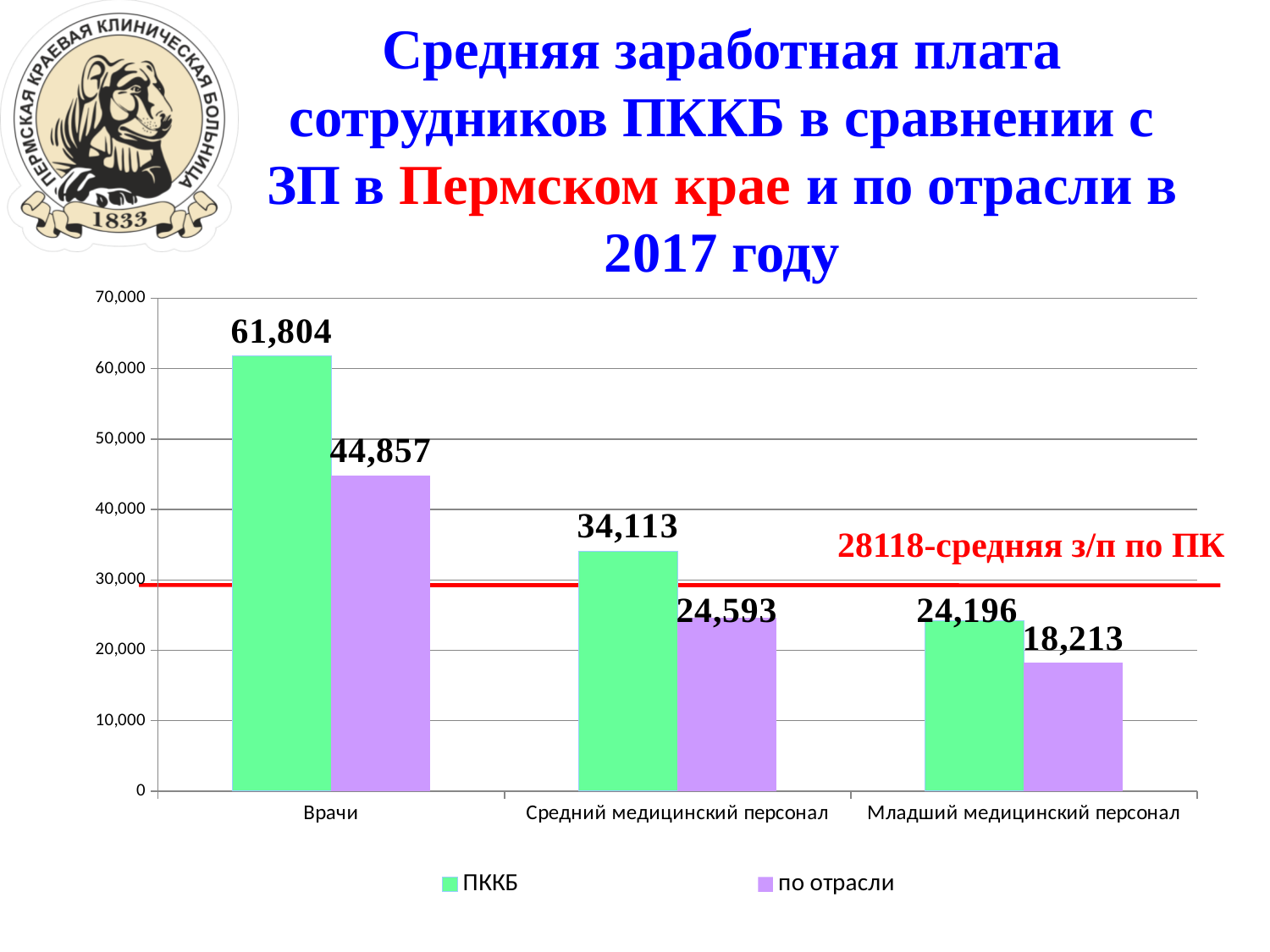
Which is larger for Средний медицинский персонал: the ПККБ value or the по отрасли value? ПККБ What is the по отрасли value for Средний медицинский персонал? 24,593 What is the ПККБ value for Младший медицинский персонал? 24,196 What kind of chart is shown on the slide? bar chart What is the difference between the ПККБ and по отрасли values for Врачи? 16,947 Which category has the highest ПККБ value? Врачи What is the difference between the ПККБ and по отрасли values for Младший медицинский персонал? 5,983 How many series does the legend list? 2 What is the ПККБ value for Врачи? 61,804 How many categories are shown on the x axis? 3 Which category has the lowest по отрасли value? Младший медицинский персонал Is the по отрасли value for Врачи greater or less than 40,000? greater